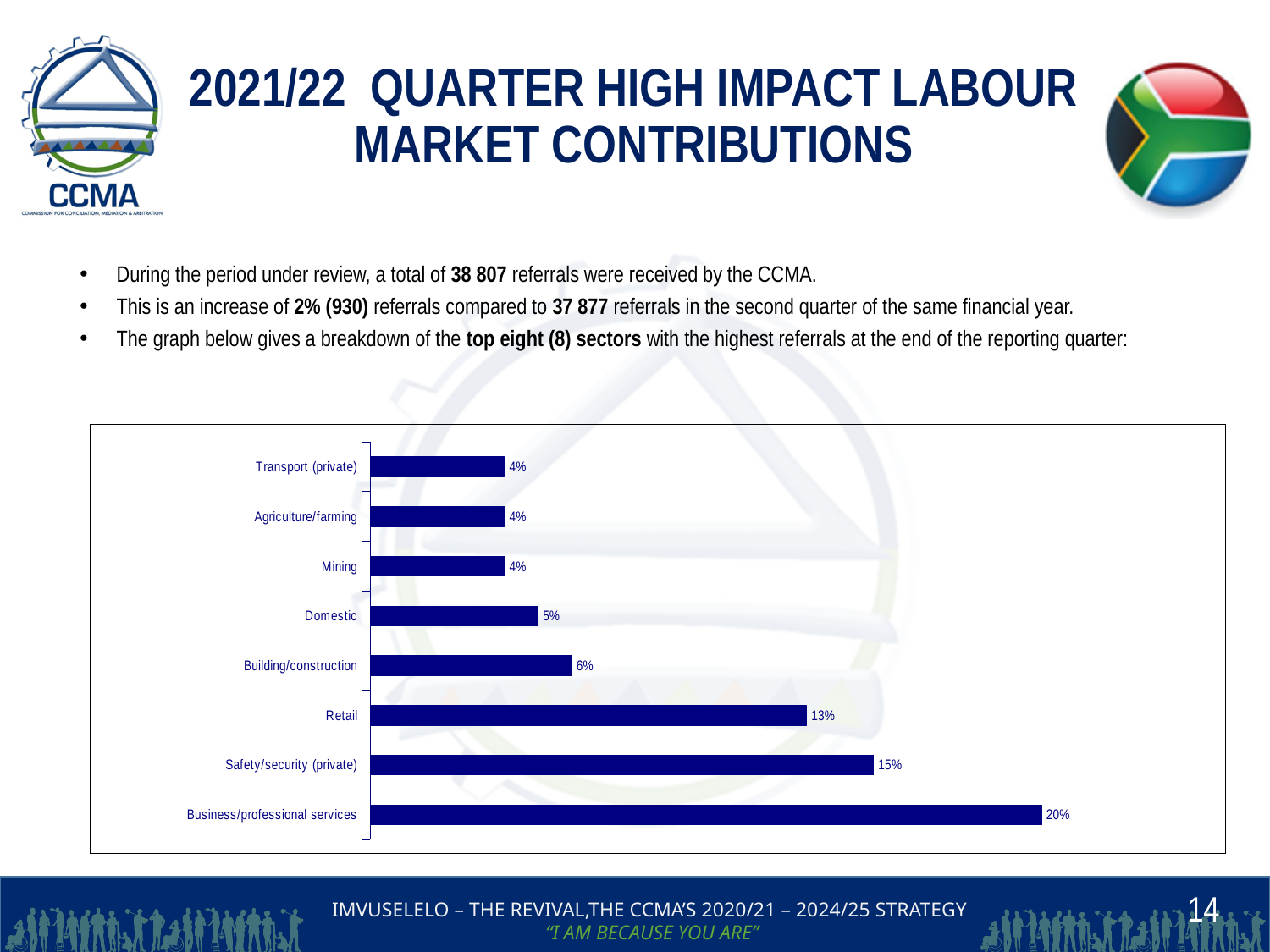
Which is larger, the value for Retail or the value for Safety/security (private)? Safety/security (private) What kind of chart is shown on the slide? Bar chart How many sectors have a value of 4%? 3 What is the difference between the values for Retail and Building/construction? 7% What is the value for Retail? 13% What is the value for Business/professional services? 20% Which is larger, the value for Domestic or the value for Building/construction? Building/construction Which sector has the highest value? Business/professional services What is the value for Domestic? 5% How many sectors are shown in the chart? 8 What is the difference between the values for Business/professional services and Safety/security (private)? 5% What is the value for Safety/security (private)? 15%